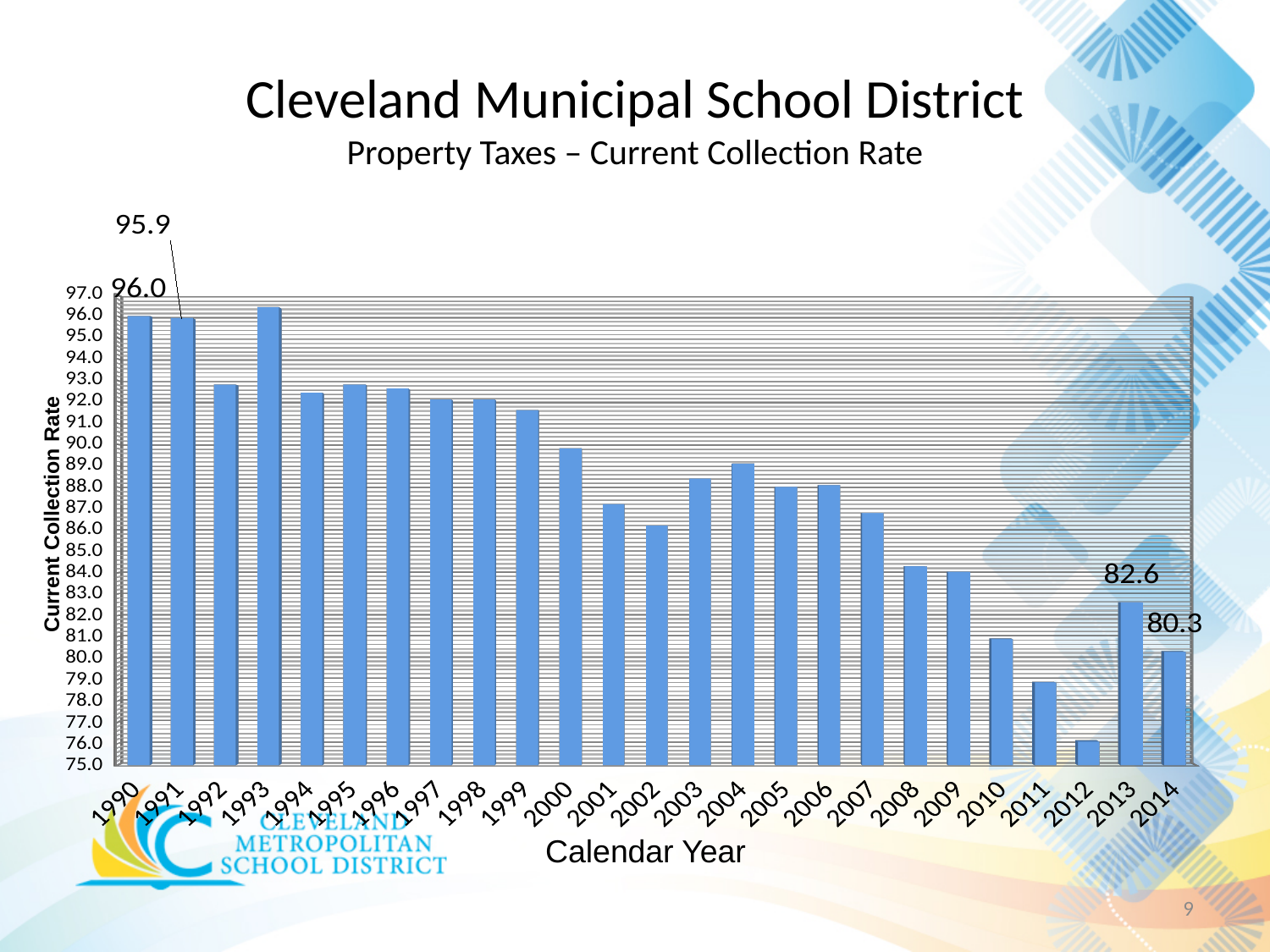
Which year has the higher collection rate, 2013 or 2014? 2013 Which calendar year has the lowest current collection rate? 2012 Is the value for 2010 greater or less than 80.0? greater What is the current collection rate for 1991? 95.9 How many calendar years are shown on the x axis? 25 What is the current collection rate for 1990? 96.0 What is the difference between the collection rates for 2013 and 2014? 2.3 What is the current collection rate for 2014? 80.3 Overall, does the current collection rate rise or fall from 1990 to 2014? Fall What kind of chart is shown on the slide? Bar chart Is the value for 2012 greater or less than 77.0? less What is the current collection rate for 2013? 82.6